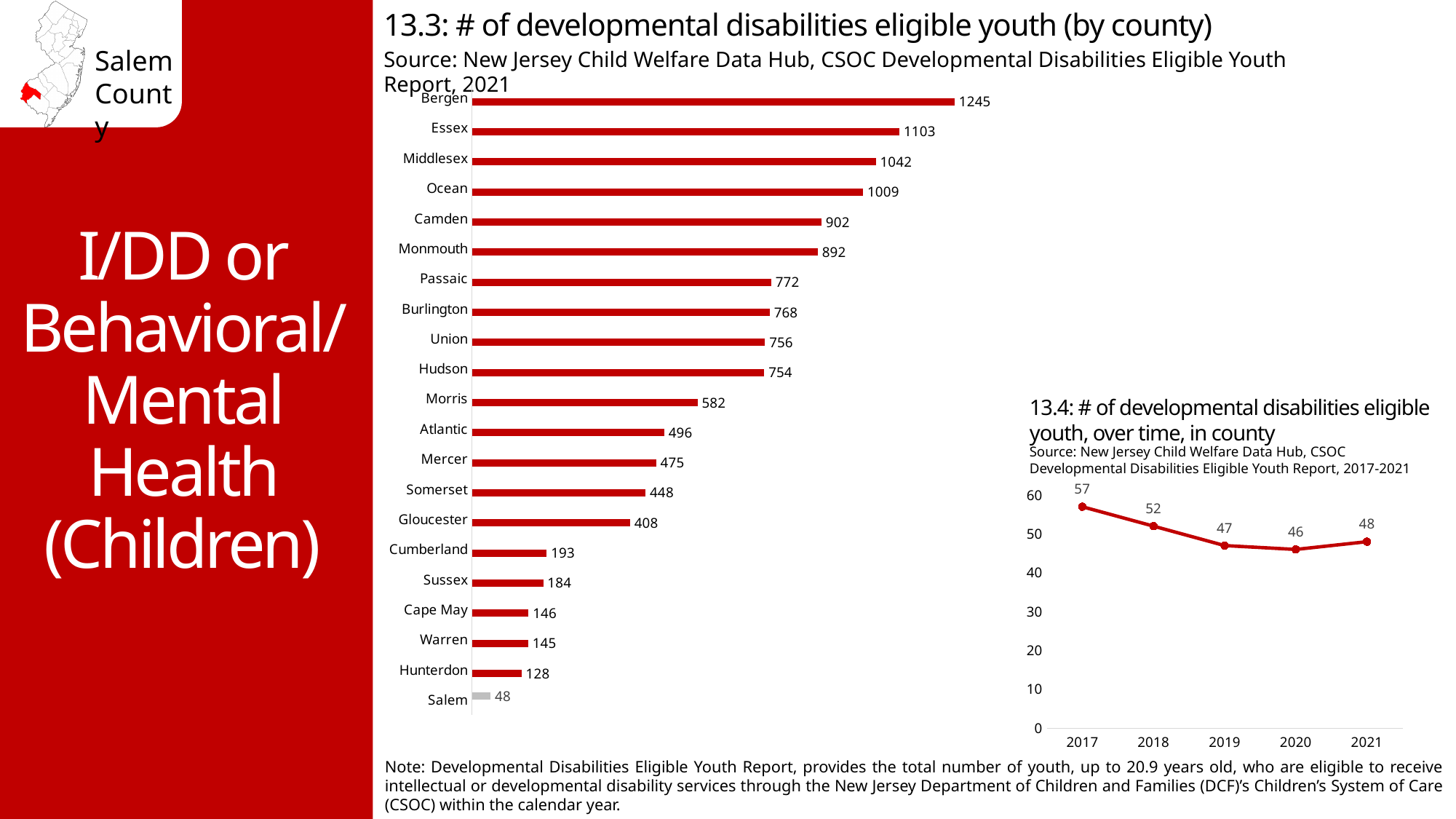
What kind of chart is chart 13.4 (# of developmental disabilities eligible youth over time, in county)? Line chart In chart 13.3 (by county), what is the difference between the values for Bergen and Essex? 142 In chart 13.4 (over time, in county), what is the difference between the values for 2017 and 2021? 9 In chart 13.3 (by county), how many counties are shown? 21 In chart 13.4 (over time, in county), what is the value for 2019? 47 In chart 13.3 (by county), what is the value for Gloucester? 408 In chart 13.3 (by county), which has a larger value, Morris or Atlantic? Morris In chart 13.3 (by county), which county has the lowest number of developmental disabilities eligible youth? Salem In chart 13.3 (# of developmental disabilities eligible youth by county), what is the value for Camden? 902 What kind of chart is chart 13.3 (# of developmental disabilities eligible youth by county)? Bar chart In chart 13.4 (over time, in county), which year has the highest value? 2017 In chart 13.3 (by county), which county has the highest number of developmental disabilities eligible youth? Bergen